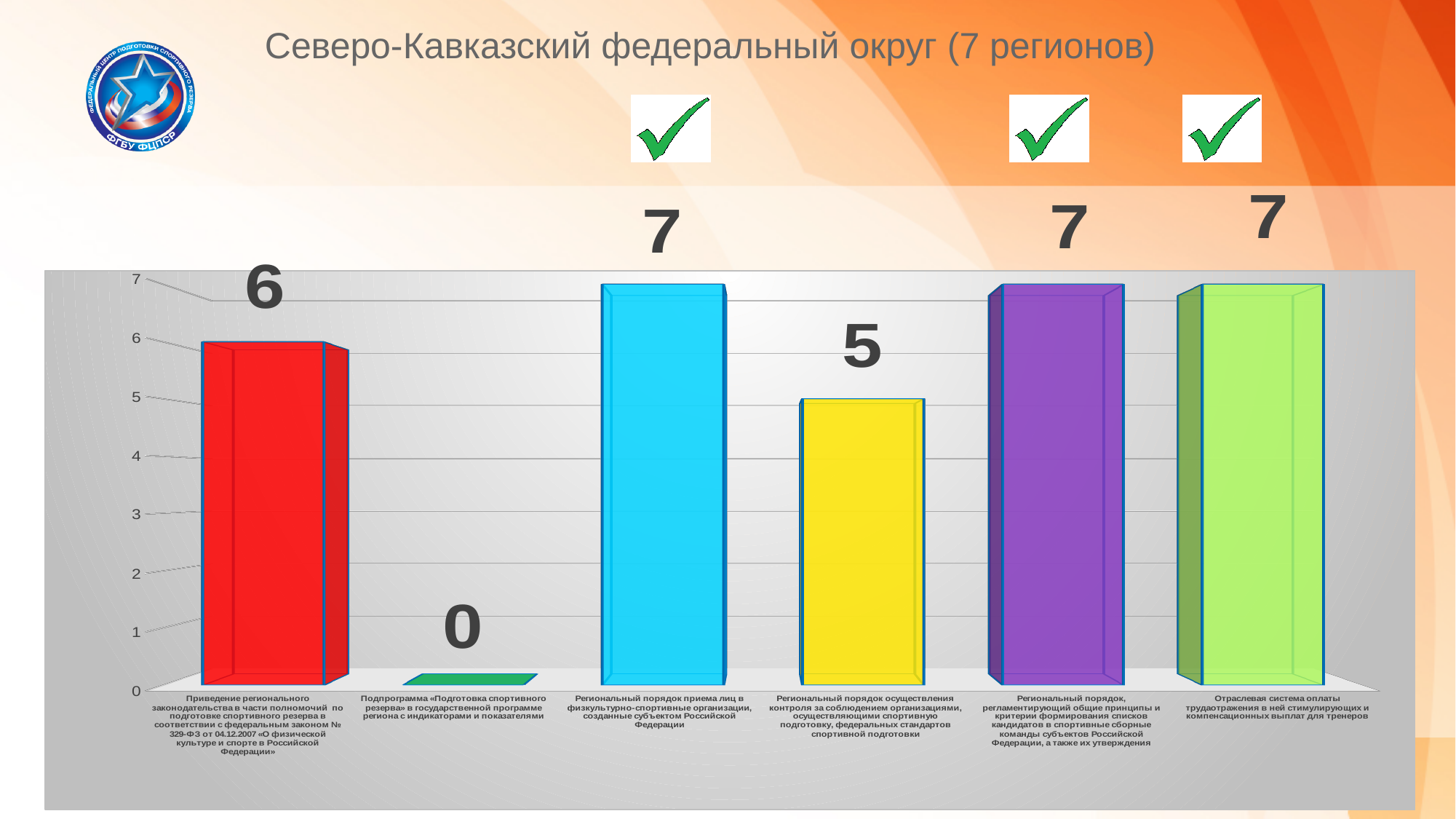
What is the highest value shown on the chart? 7 Which is larger: the value for «Приведение регионального законодательства...» or the value for «Региональный порядок осуществления контроля...»? Приведение регионального законодательства... What is the value for «Отраслевая система оплаты труда, отражения в ней стимулирующих и компенсационных выплат для тренеров»? 7 How many categories are shown on the chart? 6 What is the difference between the value for «Региональный порядок приема лиц в физкультурно-спортивные организации...» and the value for «Региональный порядок осуществления контроля...»? 2 What is the value for «Подпрограмма «Подготовка спортивного резерва» в государственной программе региона с индикаторами и показателями»? 0 What is the title of the slide? Северо-Кавказский федеральный округ (7 регионов) What is the value for «Региональный порядок осуществления контроля за соблюдением организациями, осуществляющими спортивную подготовку, федеральных стандартов спортивной подготовки»? 5 What is the value for «Приведение регионального законодательства в части полномочий по подготовке спортивного резерва...»? 6 How many categories have a value of 7? 3 What kind of chart is shown on the slide? Bar chart Which category has the lowest value? Подпрограмма «Подготовка спортивного резерва» в государственной программе региона с индикаторами и показателями